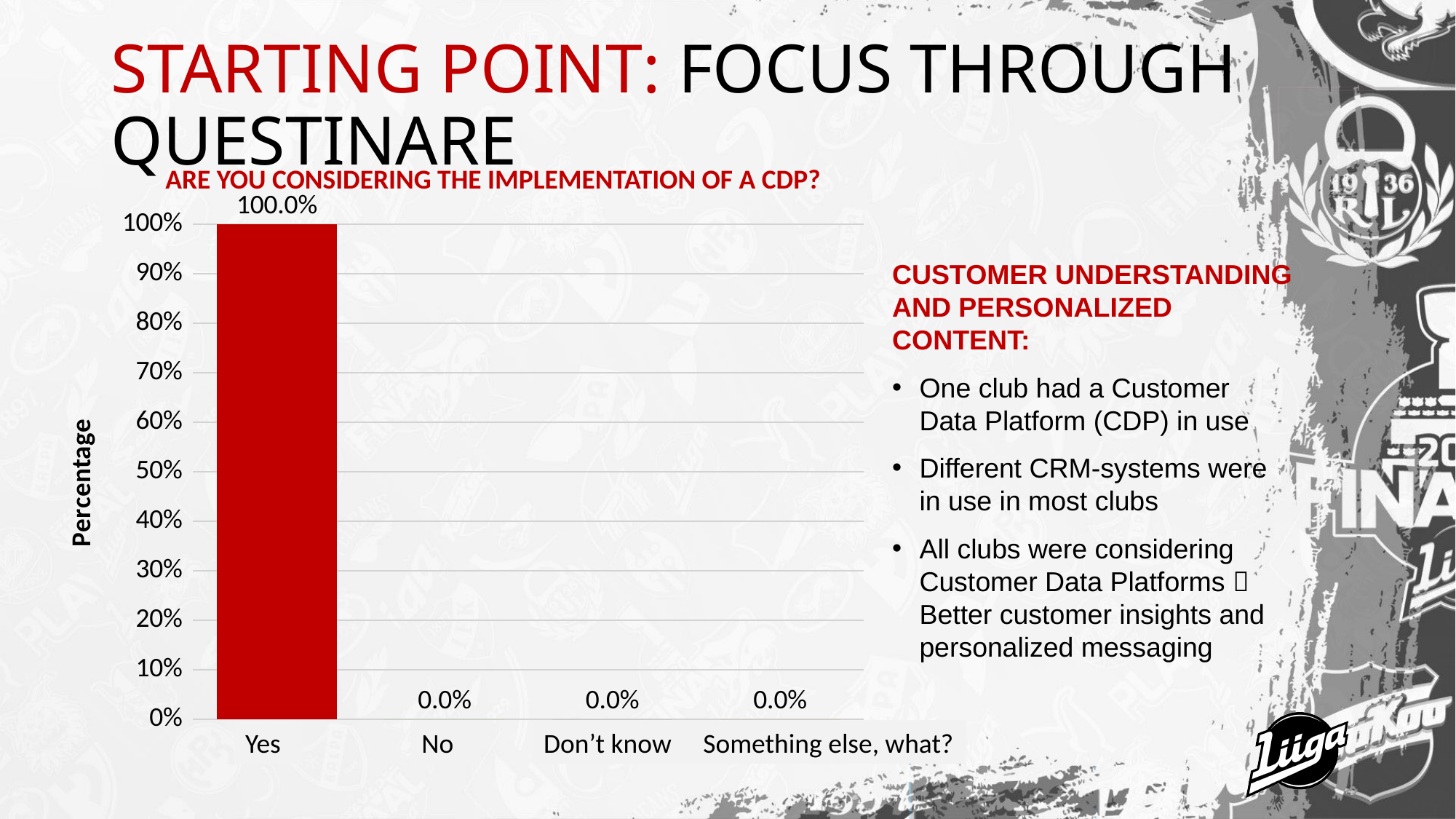
How many categories are shown on the x axis of the chart? 4 What is the title of the chart? ARE YOU CONSIDERING THE IMPLEMENTATION OF A CDP? What is the value for "No" in the chart? 0.0% Which category has the highest value in the chart? Yes Which is larger, the value for "Yes" or the value for "Don't know"? Yes Is the value for "Yes" greater or less than 50%? greater What kind of chart is shown on the slide? bar chart What is the value for "Something else, what?" in the chart? 0.0% What is the label of the vertical axis of the chart? Percentage What is the value for "Yes" in the chart? 100.0% What is the value for "Don't know" in the chart? 0.0% What is the difference between the values for "Yes" and "No"? 100.0%